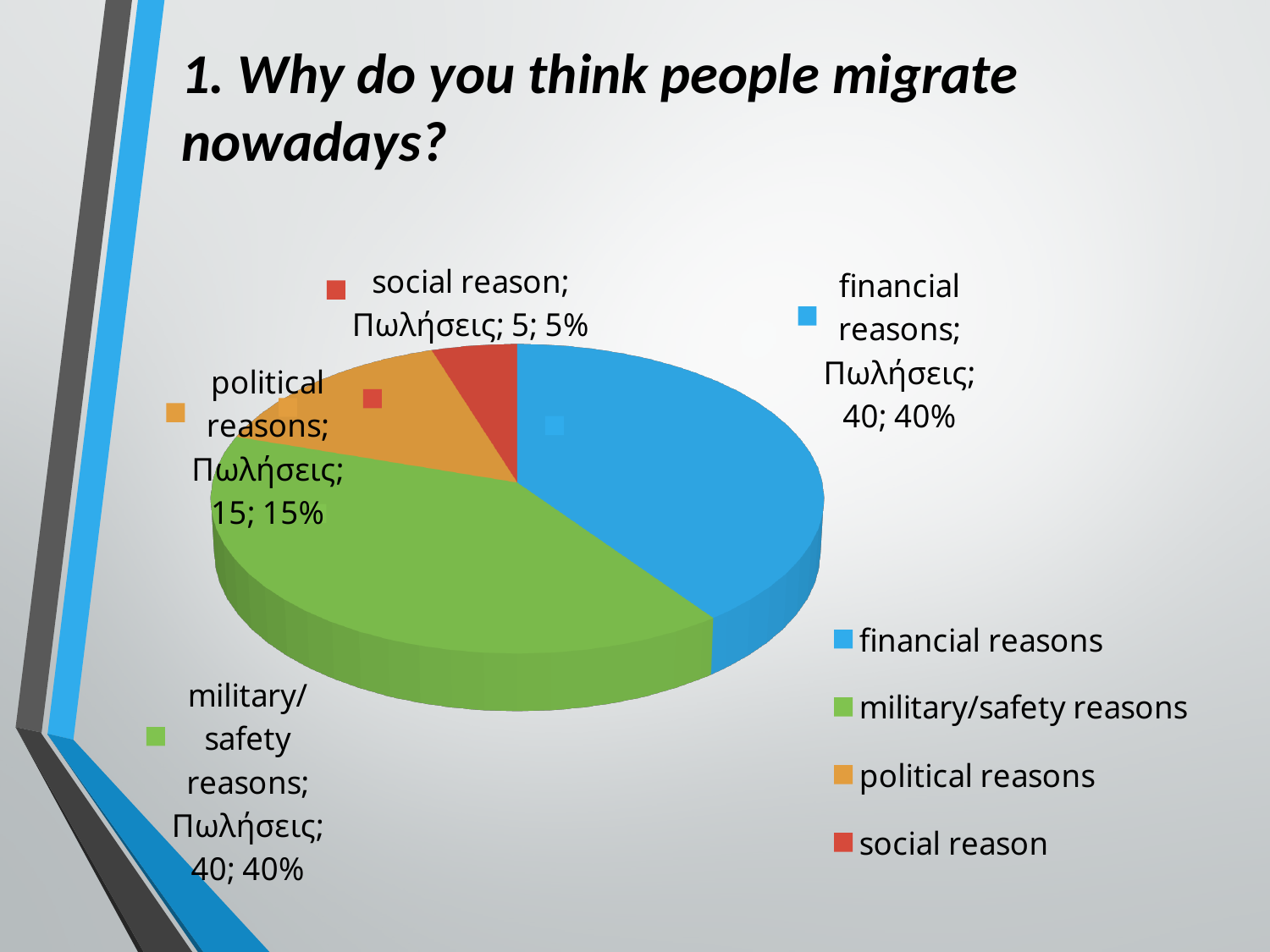
Which is larger, the slice for 'political reasons' or the slice for 'social reason'? political reasons What kind of chart is shown on the slide? pie chart What colour is the 'military/safety reasons' slice? green What value is shown for 'military/safety reasons'? 40 What percentage share does the 'financial reasons' slice have? 40% What is the difference between the values for 'financial reasons' and 'political reasons'? 25 What percentage share does the 'social reason' slice have? 5% Which category has the smallest slice of the pie? social reason What is the difference in percentage points between 'political reasons' and 'social reason'? 10 How many categories does the pie chart have? 4 What is the title of the slide containing the chart? 1. Why do you think people migrate nowadays? What value is shown for 'political reasons'? 15